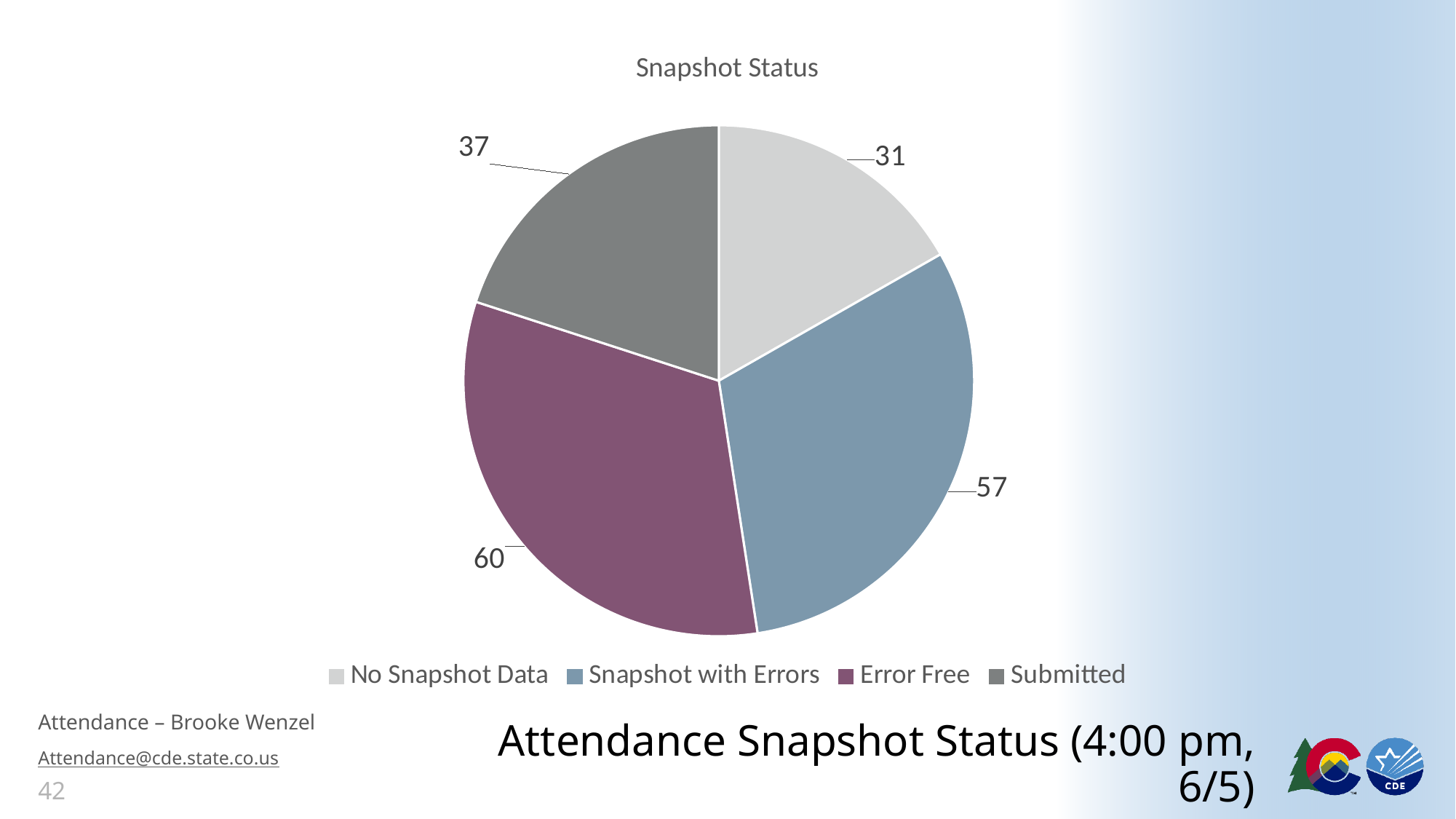
What share of the pie does the Submitted slice represent? 20% What is the title of the chart? Snapshot Status What is the difference between the Error Free and Snapshot with Errors values? 3 What is the value for Submitted? 37 Which is larger, Submitted or No Snapshot Data? Submitted What type of chart is shown on the slide? Pie chart Which category has the smallest slice? No Snapshot Data Which category has the largest slice? Error Free What is the value for Error Free? 60 What is the value for No Snapshot Data? 31 How many categories does the pie chart have? 4 What is the value for Snapshot with Errors? 57